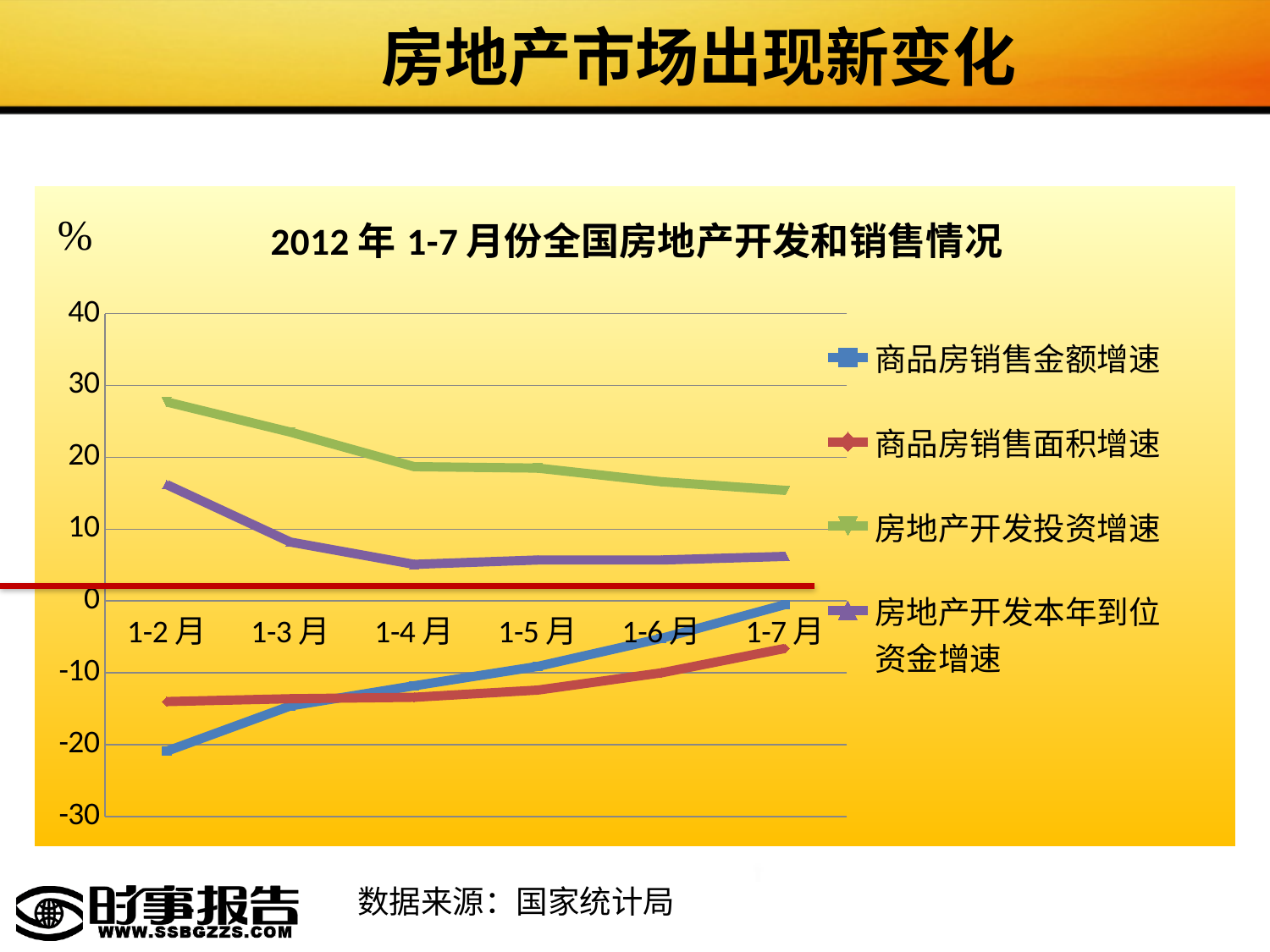
Is the value for 商品房销售面积增速 at 1-7月 greater or less than -10? greater What kind of chart is shown on the slide? line chart What is the title of the chart? 2012年1-7月份全国房地产开发和销售情况 How many points are there along the x axis? 6 How many series does the legend list? 4 Is the value for 房地产开发本年到位资金增速 at 1-7月 greater or less than 10? less Does the 房地产开发投资增速 line rise or fall from 1-2月 to 1-7月? fall Does the 商品房销售金额增速 line rise or fall from 1-2月 to 1-7月? rise Which series has the lowest value at 1-2月? 商品房销售金额增速 Is the value for 房地产开发投资增速 at 1-2月 greater or less than 20? greater At 1-2月, which is higher: 房地产开发投资增速 or 房地产开发本年到位资金增速? 房地产开发投资增速